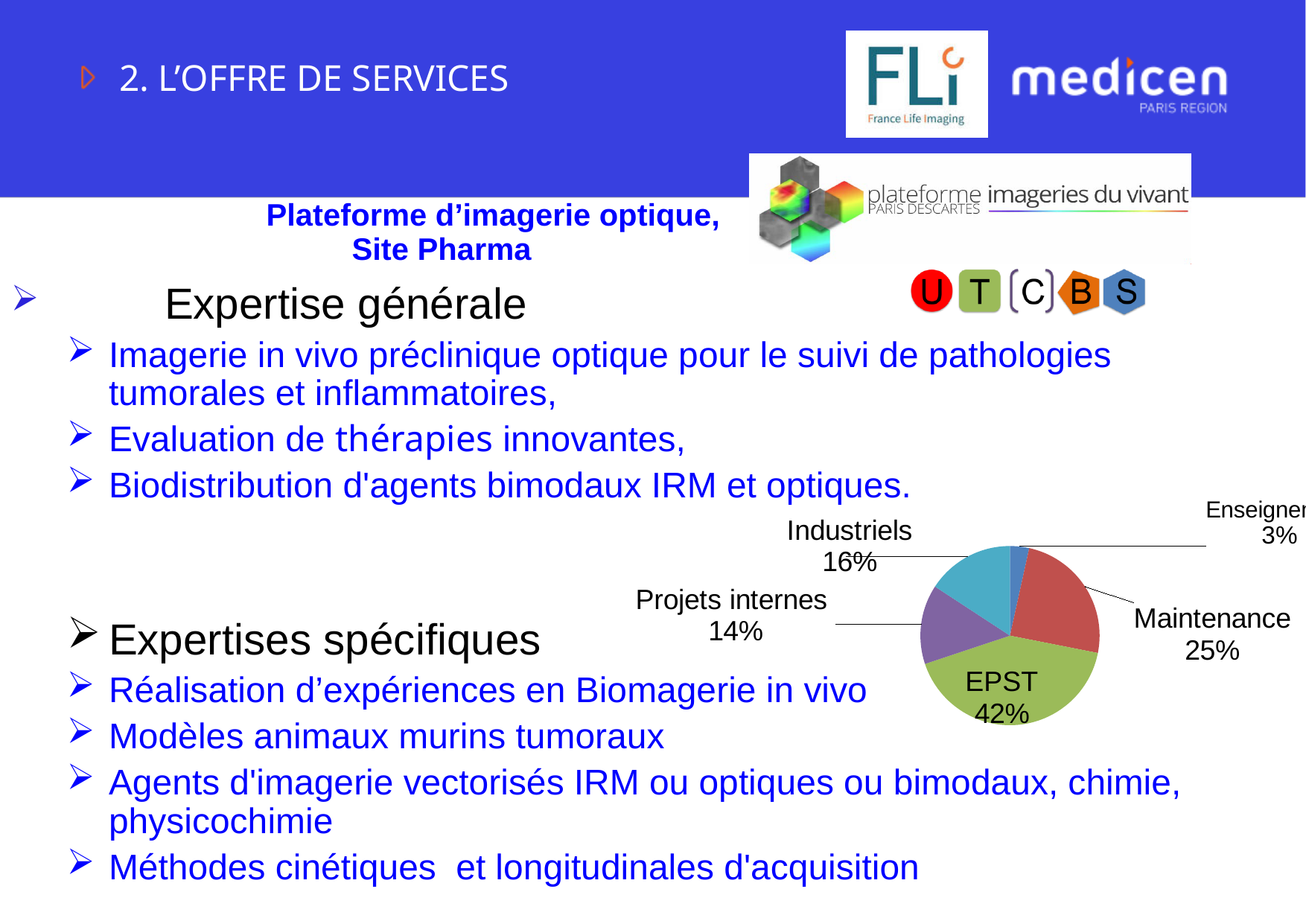
What percentage does the Industriels slice represent in the pie chart? 16% What percentage does the Maintenance slice represent in the pie chart? 25% Which category has the largest slice in the pie chart? EPST What percentage does the Projets internes slice represent in the pie chart? 14% What is the difference in percentage points between the Maintenance slice and the Industriels slice? 9% What percentage does the EPST slice represent in the pie chart? 42% How many slices does the pie chart have? 5 Which slice is larger, Industriels or Projets internes? Industriels What colour is the EPST slice in the pie chart? green What share of the pie do EPST and Maintenance represent together? 67% What is the difference in percentage points between the EPST slice and the Maintenance slice? 17% What kind of chart is shown on the slide? pie chart